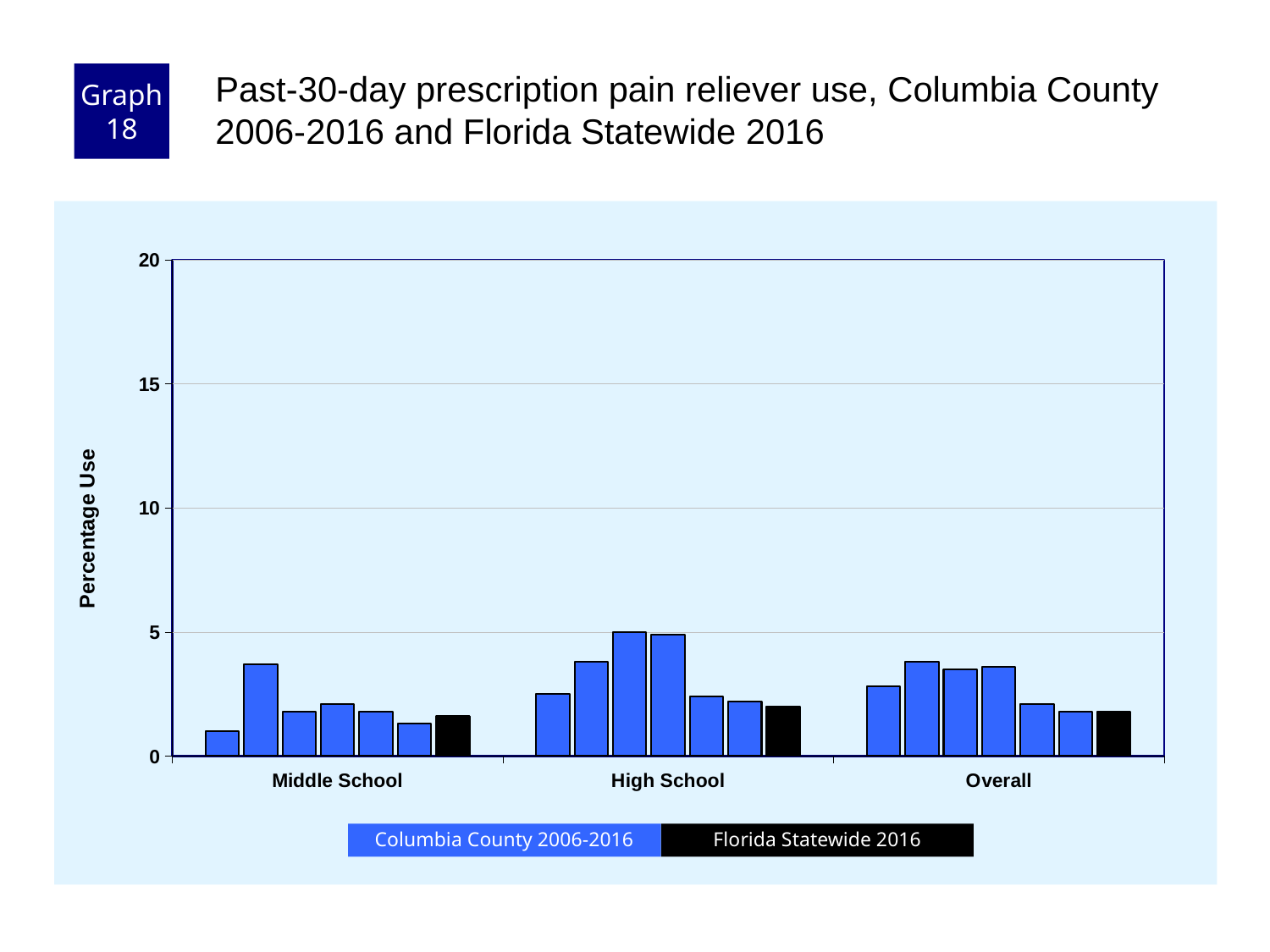
How many bars are plotted in the High School group? 7 Which category group contains the tallest bar on the chart? High School What colour represents Florida Statewide 2016 in the legend? black How many school-level categories are shown on the x axis? 3 What kind of chart is shown on the slide? bar chart Is the Florida Statewide 2016 value for High School greater or less than 5? less What is the label on the y axis? Percentage Use Which is larger: the tallest Columbia County bar for High School or the tallest Columbia County bar for Middle School? High School Are any of the plotted values greater than 10? No How many series does the legend list? 2 Is the tallest Columbia County bar in the Overall group greater or less than 5? less